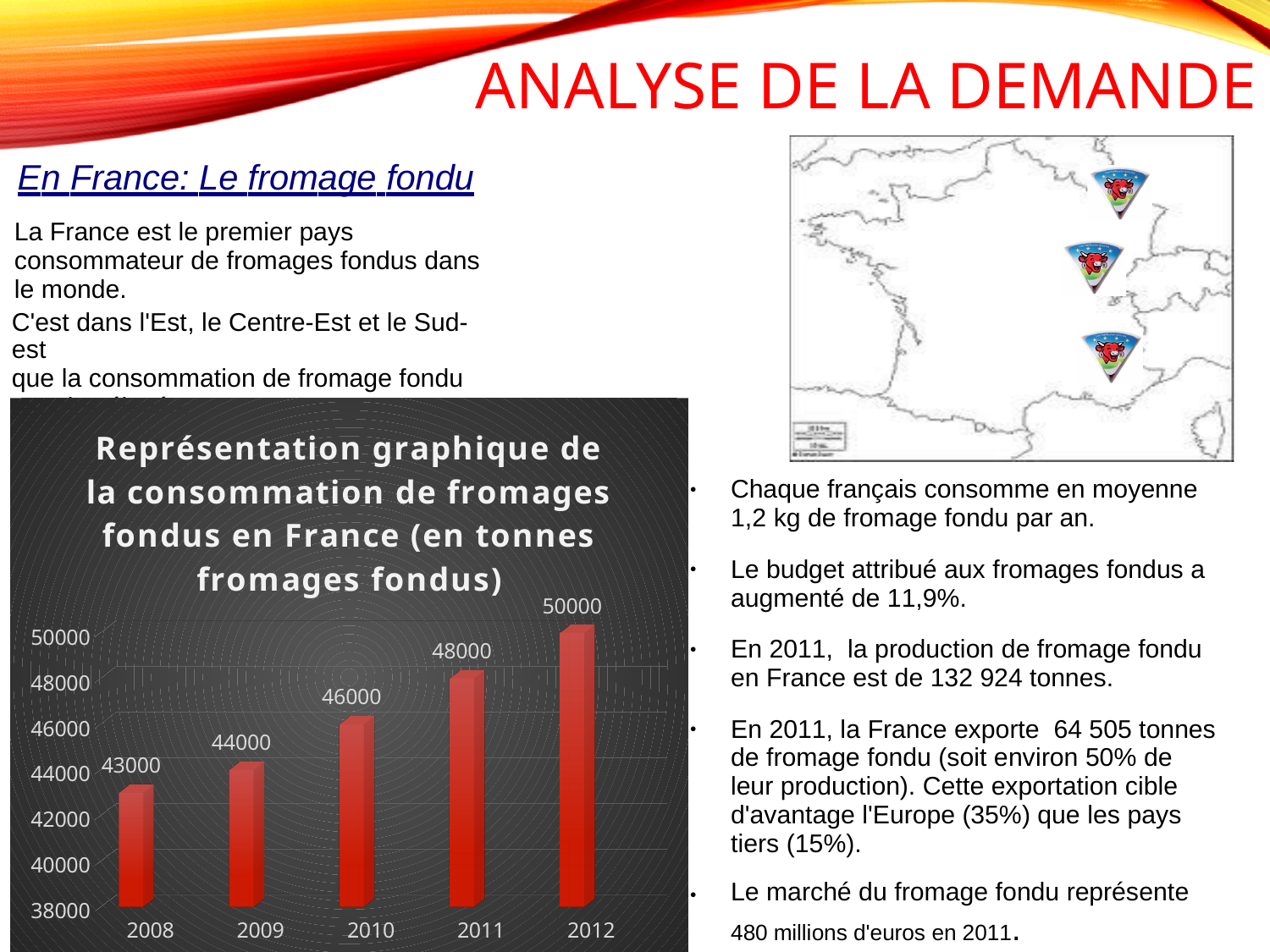
What is the value for 2010? 46000 What is the value for 2008? 43000 What unit does the chart title say the values are in? tonnes fromages fondus What is the difference between the values for 2012 and 2008? 7000 Which year has the lowest value? 2008 How many years are shown on the x axis? 5 Which is larger, the value for 2009 or the value for 2011? 2011 What kind of chart is this? bar chart Which year has the highest value? 2012 What is the difference between the values for 2011 and 2009? 4000 Do the values rise or fall from 2008 to 2012? rise What is the value for 2012? 50000